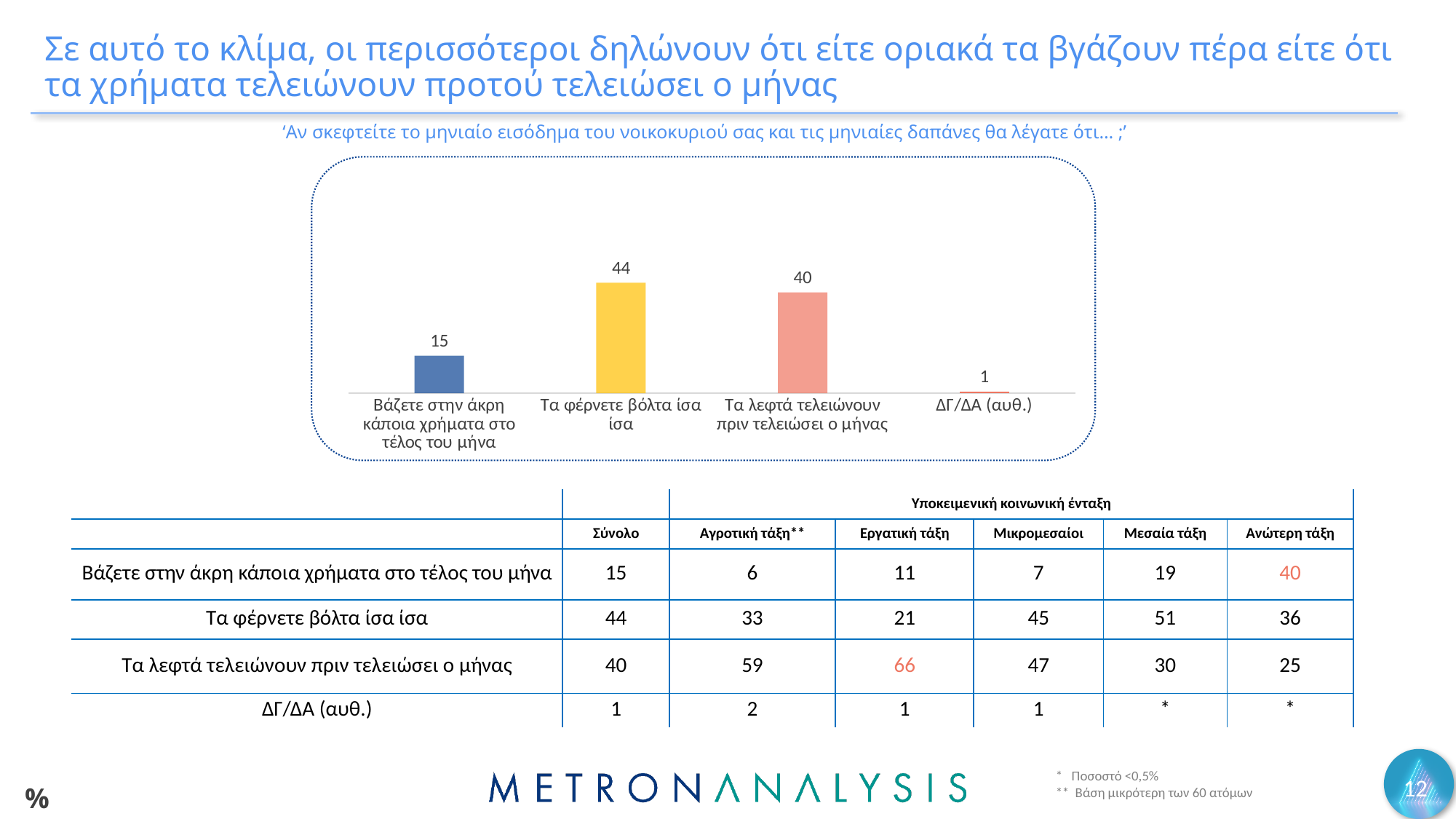
What value is shown for 'Βάζετε στην άκρη κάποια χρήματα στο τέλος του μήνα' in the bar chart? 15 What is the difference between the values for 'Τα λεφτά τελειώνουν πριν τελειώσει ο μήνας' and 'Βάζετε στην άκρη κάποια χρήματα στο τέλος του μήνα'? 25 How many categories are shown in the bar chart? 4 Which category has the highest value in the bar chart? Τα φέρνετε βόλτα ίσα ίσα What value is shown for 'Τα φέρνετε βόλτα ίσα ίσα' in the bar chart? 44 Which category has the lowest value in the bar chart? ΔΓ/ΔΑ (αυθ.) What is the difference between the values for 'Τα φέρνετε βόλτα ίσα ίσα' and 'Τα λεφτά τελειώνουν πριν τελειώσει ο μήνας'? 4 What kind of chart is shown on the slide? Bar chart What value is shown for 'Τα λεφτά τελειώνουν πριν τελειώσει ο μήνας' in the bar chart? 40 Which is larger in the bar chart: the value for 'Βάζετε στην άκρη κάποια χρήματα στο τέλος του μήνα' or the value for 'Τα λεφτά τελειώνουν πριν τελειώσει ο μήνας'? Τα λεφτά τελειώνουν πριν τελειώσει ο μήνας What value is shown for 'ΔΓ/ΔΑ (αυθ.)' in the bar chart? 1 What colour is the bar for 'Τα φέρνετε βόλτα ίσα ίσα' in the chart? Yellow